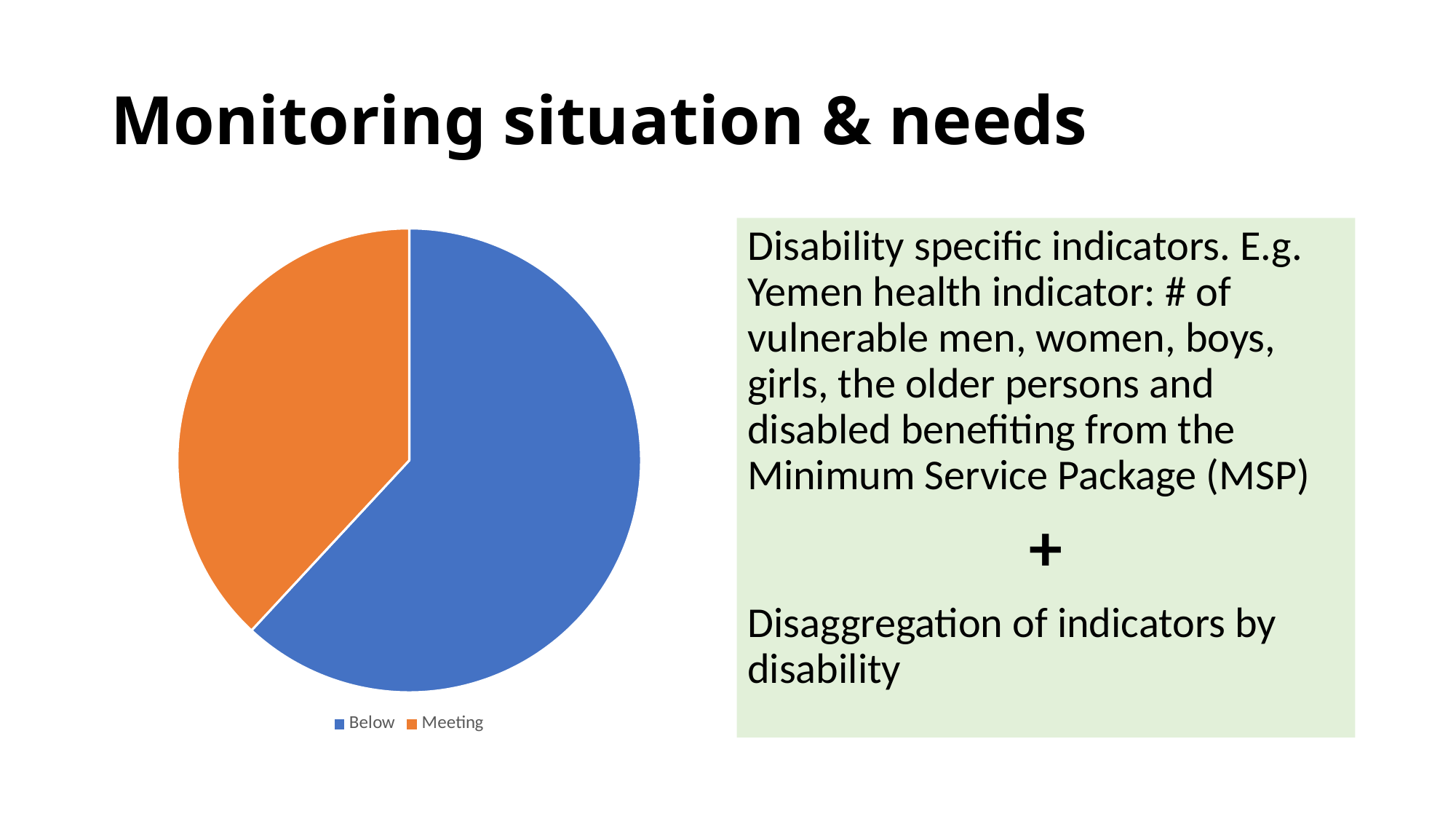
Which category has the smallest slice in the pie chart? Meeting What colour is the Meeting slice in the pie chart? orange How many entries does the legend of the pie chart list? 2 What kind of chart is shown on the slide? pie chart What colour is the Below slice in the pie chart? blue Which slice is larger in the pie chart, Below or Meeting? Below Which category has the largest slice in the pie chart? Below Does the Below slice take up more or less than half of the pie chart? more How many slices does the pie chart have? 2